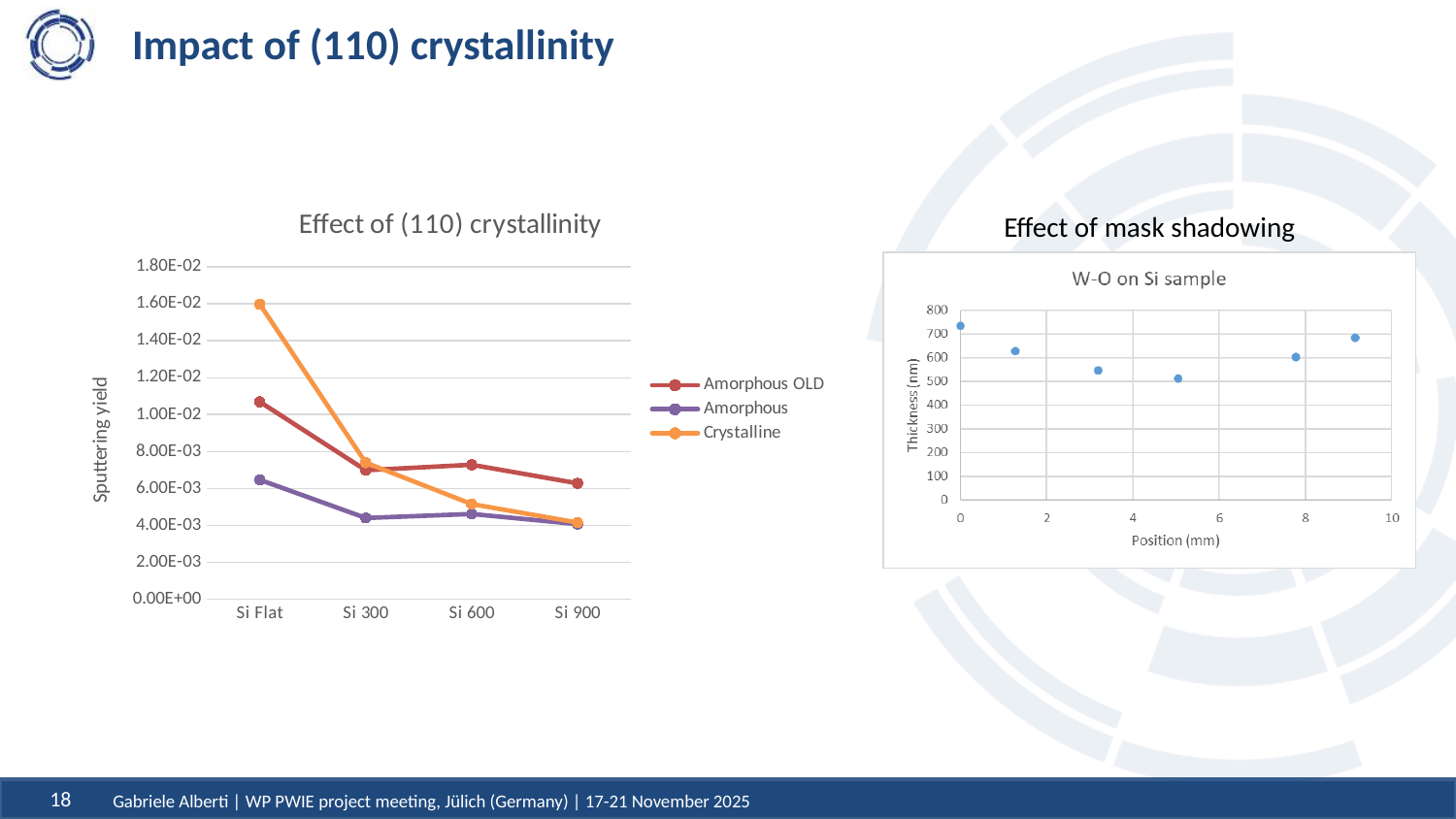
In the 'Effect of (110) crystallinity' chart, is the Crystalline value at Si Flat greater or less than 1.40E-02? greater In the 'W-O on Si sample' chart on the right, how many data points are plotted? 6 In the 'Effect of (110) crystallinity' chart, which series has the lowest sputtering yield at Si Flat? Amorphous In the 'Effect of (110) crystallinity' chart, how many series does the legend list? 3 In the 'Effect of (110) crystallinity' chart, does the Crystalline series rise or fall from Si Flat to Si 900? fall In the 'W-O on Si sample' chart on the right, what kind of chart is it? scatter chart In the 'Effect of (110) crystallinity' chart, is the Amorphous value at Si 300 greater or less than 6.00E-03? less In the 'Effect of (110) crystallinity' chart, which series has the highest sputtering yield at Si Flat? Crystalline In the 'Effect of (110) crystallinity' chart, at Si 600, which is larger: Amorphous OLD or Crystalline? Amorphous OLD In the 'Effect of (110) crystallinity' chart, how many categories are on the x axis? 4 In the 'Effect of (110) crystallinity' chart, what kind of chart is it? line chart In the 'W-O on Si sample' chart on the right, is the thickness at position 0 greater or less than 700? greater